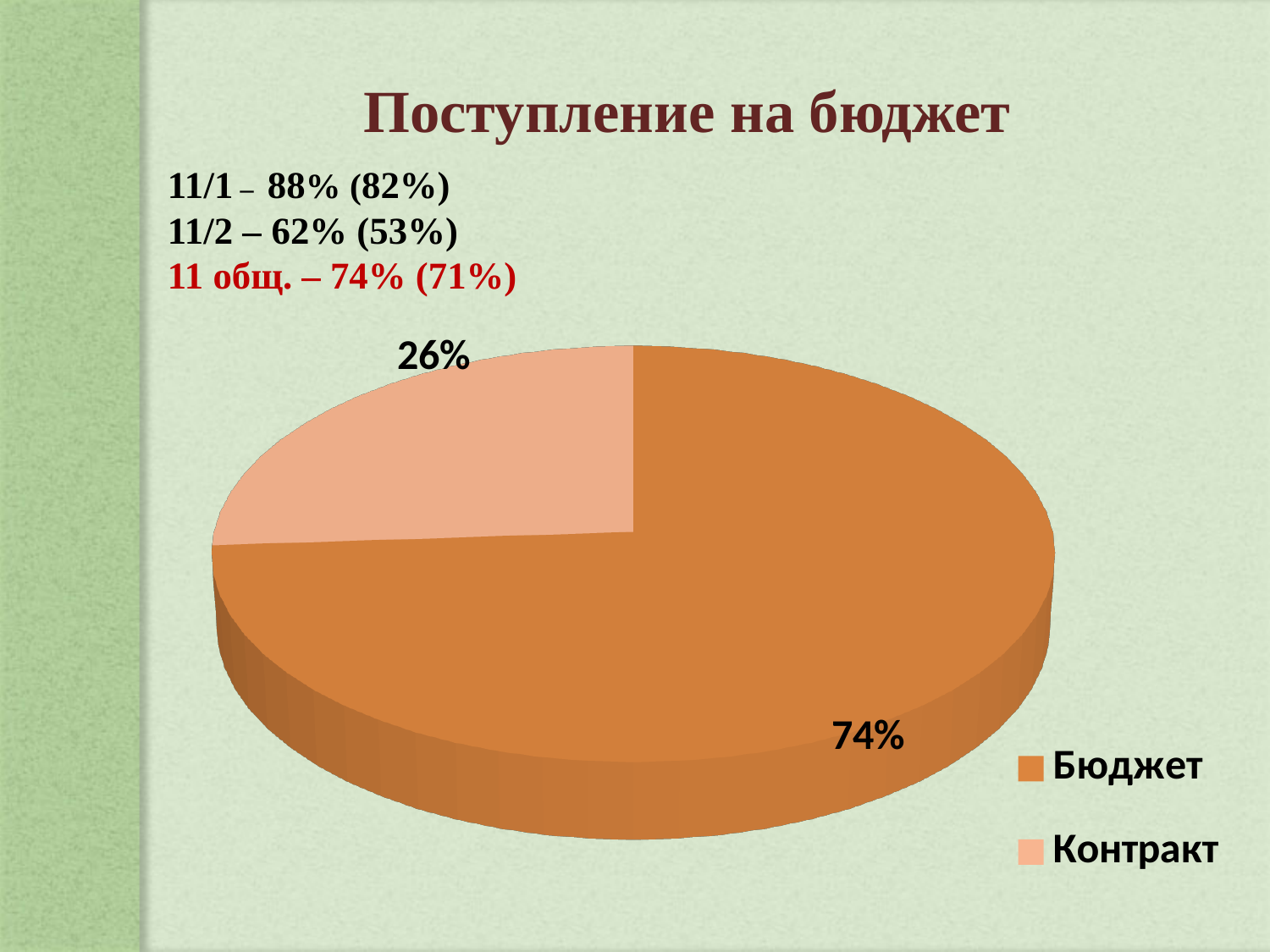
What share of the pie does the Контракт slice represent? 26% What is the title of the slide? Поступление на бюджет How many slices does the pie chart have? 2 What share of the pie does the Бюджет slice represent? 74% Which slice of the pie is the largest? Бюджет Which legend entry is shown in the lighter colour? Контракт What is the total of the two slice percentages shown on the pie? 100% Which is larger, the Бюджет slice or the Контракт slice? Бюджет What kind of chart is shown on the slide? Pie chart Which slice of the pie is the smallest? Контракт How many entries does the legend list? 2 What is the difference in percentage points between the Бюджет and Контракт slices? 48